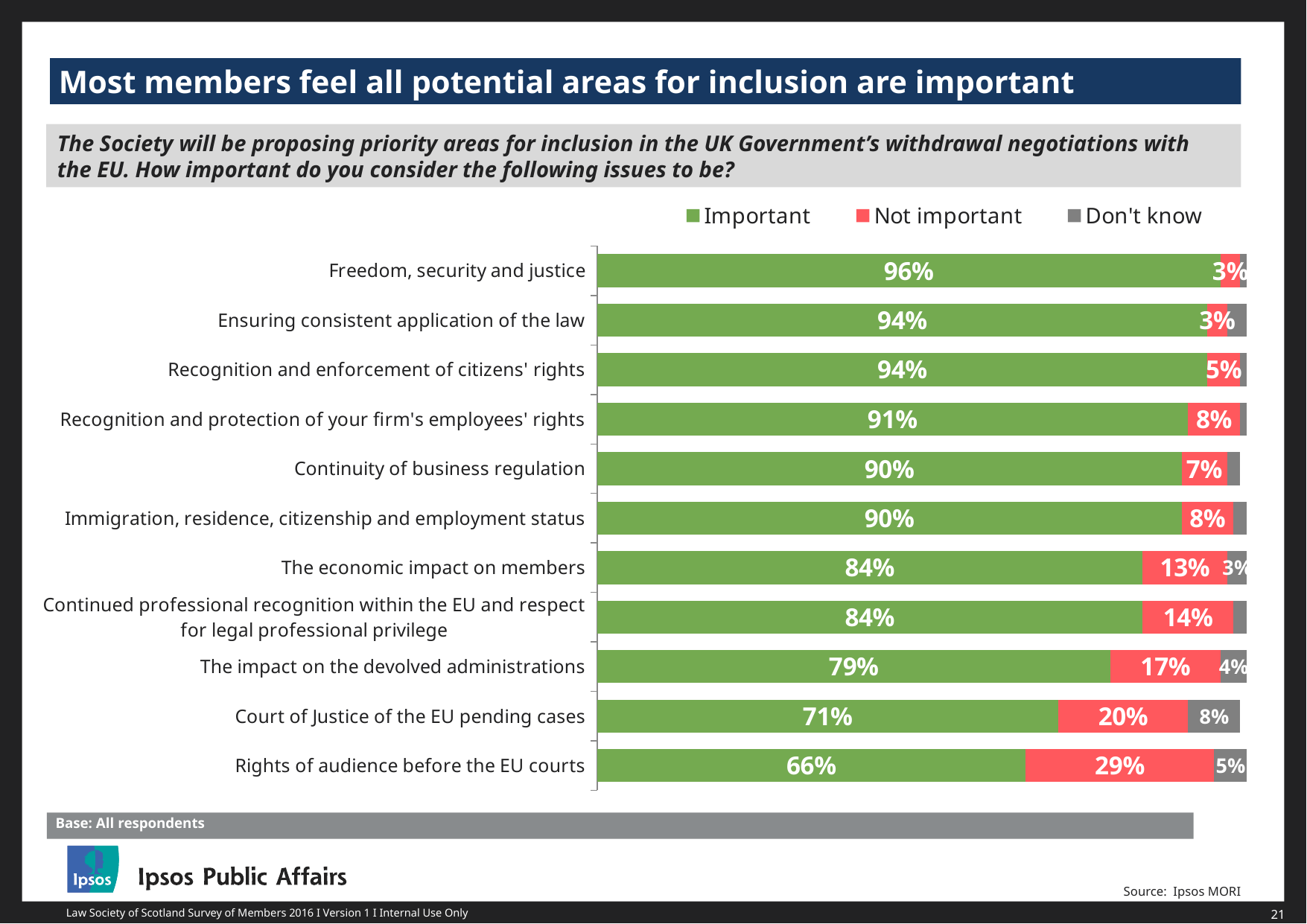
Which has a larger Not important share: 'Court of Justice of the EU pending cases' or 'The impact on the devolved administrations'? Court of Justice of the EU pending cases What percentage rated 'The impact on the devolved administrations' as Important? 79% What percentage rated 'Rights of audience before the EU courts' as Not important? 29% What is the total of the three segments for 'The economic impact on members'? 100% What percentage of members rated 'Freedom, security and justice' as Important? 96% What is the Don't know percentage for 'Court of Justice of the EU pending cases'? 8% What kind of chart is shown on the slide? Stacked bar chart Which issue has the lowest Important percentage? Rights of audience before the EU courts Which issue has the highest Important percentage? Freedom, security and justice How many issues are listed in the chart? 11 How many series does the legend list? 3 What is the difference in the Important percentage between 'Freedom, security and justice' and 'Rights of audience before the EU courts'? 30 percentage points